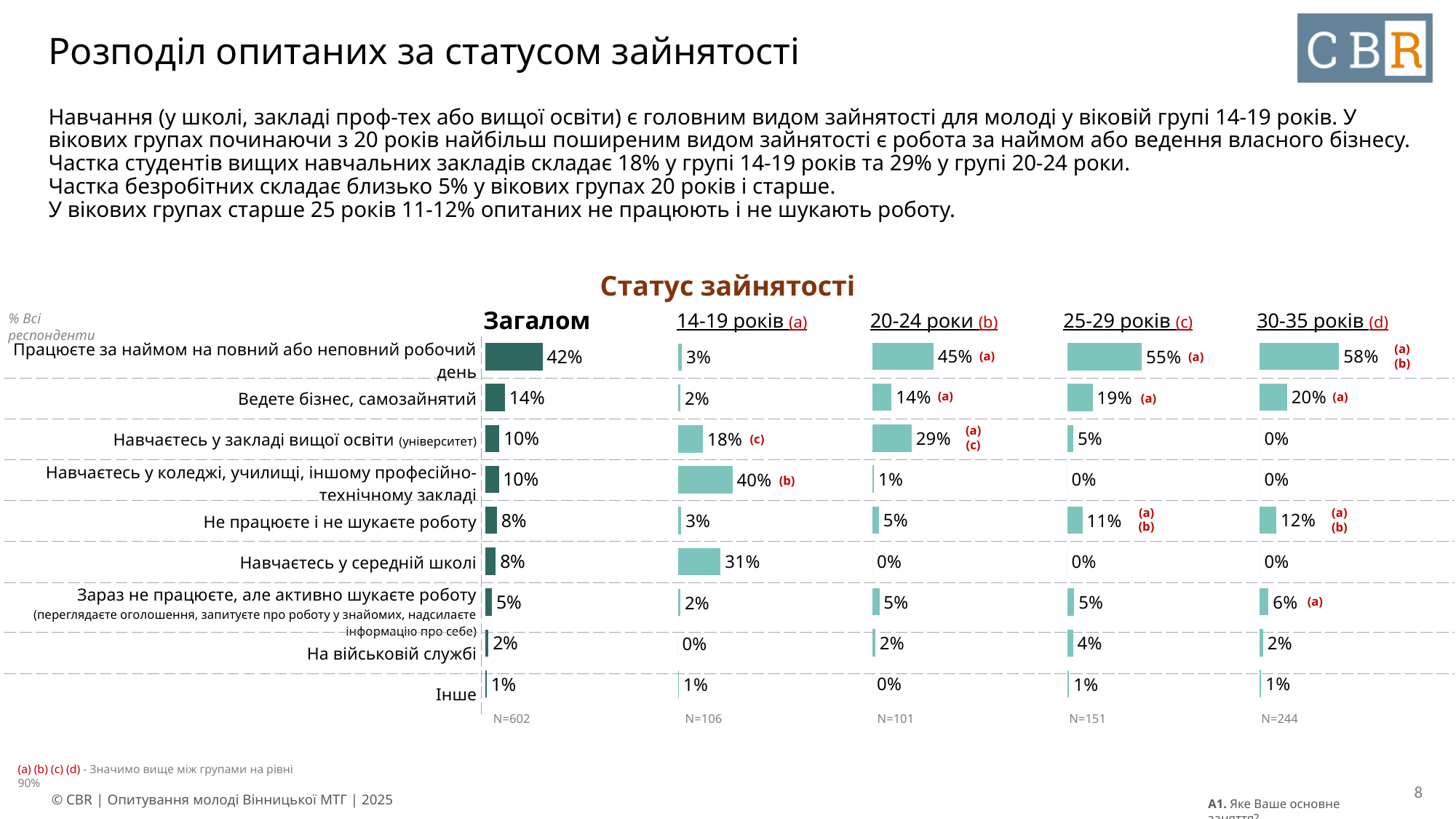
In the 'Статус зайнятості' chart, which employment status has the highest value in the 30-35 років group? Працюєте за наймом на повний або неповний робочий день What type of chart is 'Статус зайнятості'? Bar chart In the 'Статус зайнятості' chart, which employment status has the lowest 'Загалом' value? Інше In the 'Статус зайнятості' chart, how many employment status categories are listed? 9 In the 'Статус зайнятості' chart, how many respondent groups (columns) are shown? 5 In the 'Статус зайнятості' chart, what share of the 14-19 років group is 'Навчаєтесь у коледжі, училищі, іншому професійно-технічному закладі'? 40% In the 'Статус зайнятості' chart, what is the difference between the 30-35 років and 14-19 років values for 'Працюєте за наймом на повний або неповний робочий день'? 55% In the 'Статус зайнятості' chart, what is the sample size (N) for the 30-35 років group? N=244 In the 'Статус зайнятості' chart, what is the value for 'Навчаєтесь у середній школі' in the 14-19 років group? 31% In the 'Статус зайнятості' chart, which is larger for 'Ведете бізнес, самозайнятий': the 25-29 років value or the 20-24 роки value? 25-29 років In the 'Статус зайнятості' chart, what is the value for 'Навчаєтесь у закладі вищої освіти' in the 20-24 роки group? 29% In the 'Статус зайнятості' chart, what is the 'Загалом' value for 'Працюєте за наймом на повний або неповний робочий день'? 42%